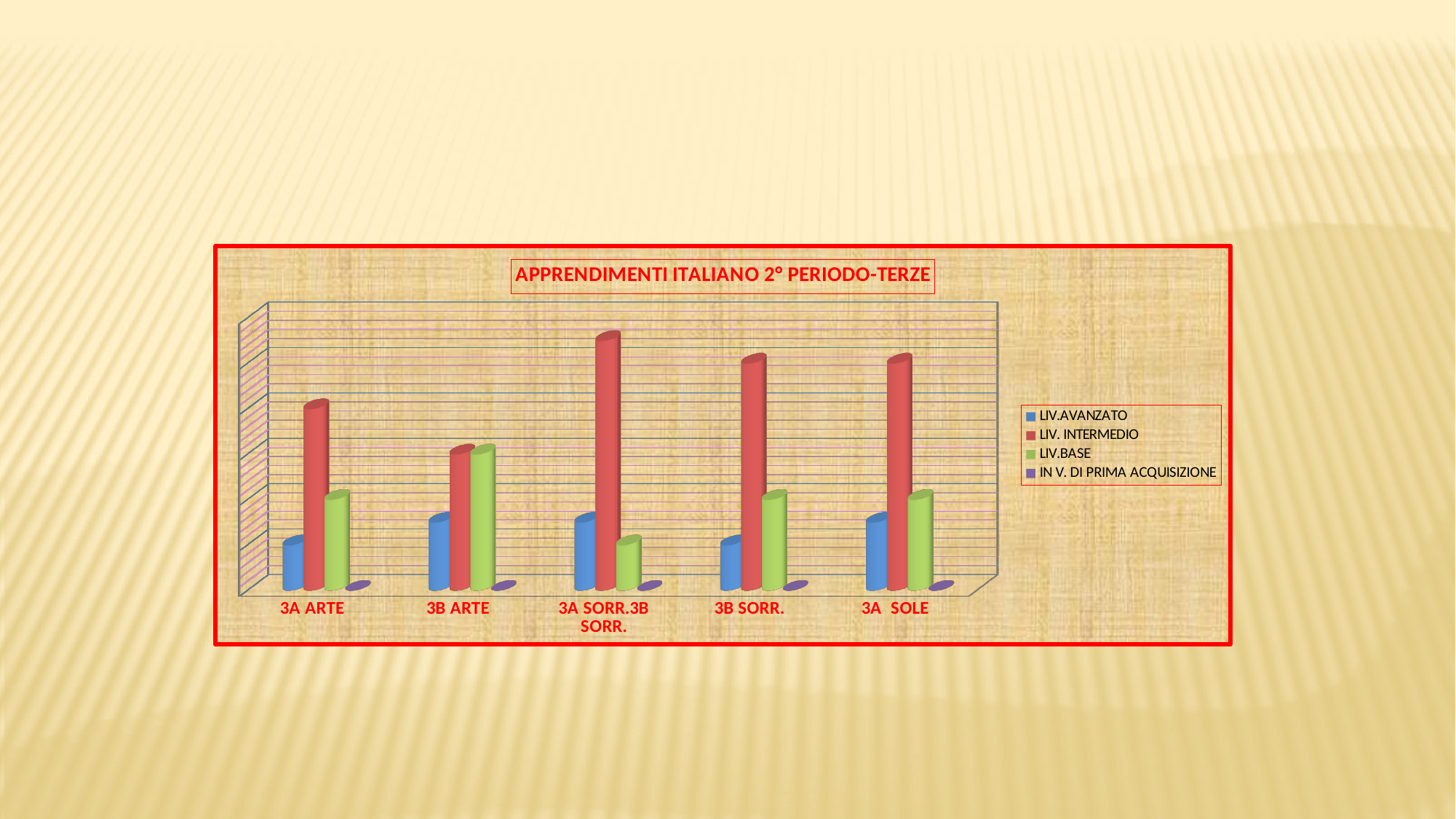
How many series does the legend list? 4 Which category has the lowest LIV. INTERMEDIO bar? 3B ARTE What is the title of the chart? APPRENDIMENTI ITALIANO 2° PERIODO-TERZE For 3A ARTE, which is larger: LIV.AVANZATO or LIV.BASE? LIV.BASE Is the LIV. INTERMEDIO bar larger for 3A ARTE or for 3A SORR.3B SORR.? 3A SORR.3B SORR. How many categories are shown on the x axis? 5 What kind of chart is shown on the slide? bar chart Which category has the highest LIV.BASE bar? 3B ARTE Which series has the lowest values across all categories? IN V. DI PRIMA ACQUISIZIONE Which category has the lowest LIV.BASE bar? 3A SORR.3B SORR. Which series is shown in red? LIV. INTERMEDIO Which category has the highest LIV. INTERMEDIO bar? 3A SORR.3B SORR.